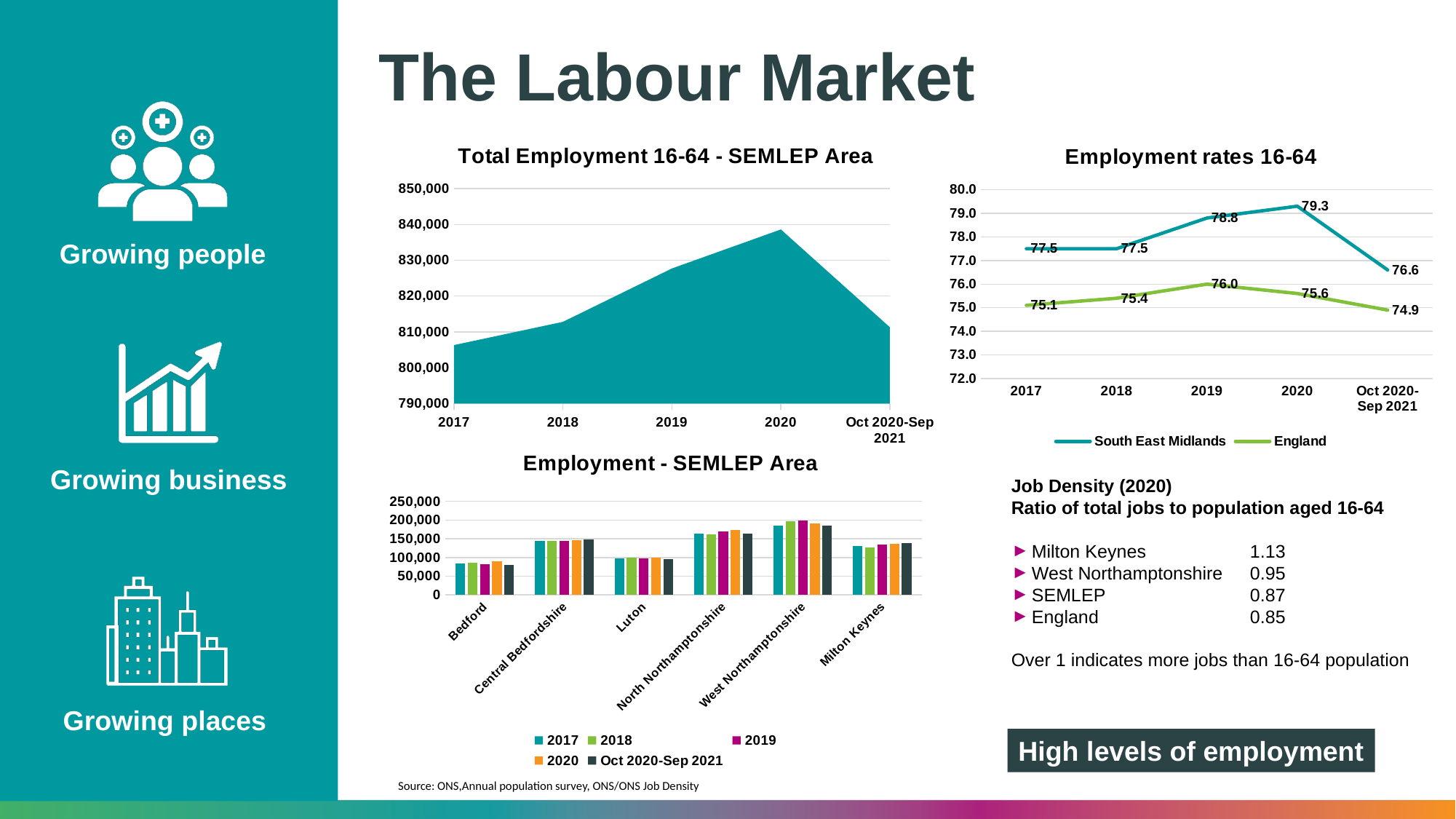
In the 'Employment rates 16-64' chart, what is the employment rate for South East Midlands in 2020? 79.3 In the 'Employment - SEMLEP Area' bar chart, which area has the highest employment? West Northamptonshire In the 'Employment rates 16-64' chart, in which period is the South East Midlands employment rate highest? 2020 In the 'Total Employment 16-64 - SEMLEP Area' chart, in which period does total employment peak? 2020 In the 'Total Employment 16-64 - SEMLEP Area' chart, is the value for 2017 greater or less than 810,000? less In the 'Employment - SEMLEP Area' bar chart, how many series does the legend list? 5 In the 'Employment rates 16-64' chart, what is the difference between the South East Midlands and England rates in 2020? 3.7 In the 'Employment rates 16-64' chart, what is the employment rate for England in 2019? 76.0 In the 'Employment rates 16-64' chart, how many series does the legend list? 2 In the 'Employment - SEMLEP Area' bar chart, is the 2017 value for Bedford greater or less than 100,000? less In the 'Employment rates 16-64' chart, in which period is the England employment rate lowest? Oct 2020-Sep 2021 In the 'Employment rates 16-64' chart, what is the England value for Oct 2020-Sep 2021? 74.9